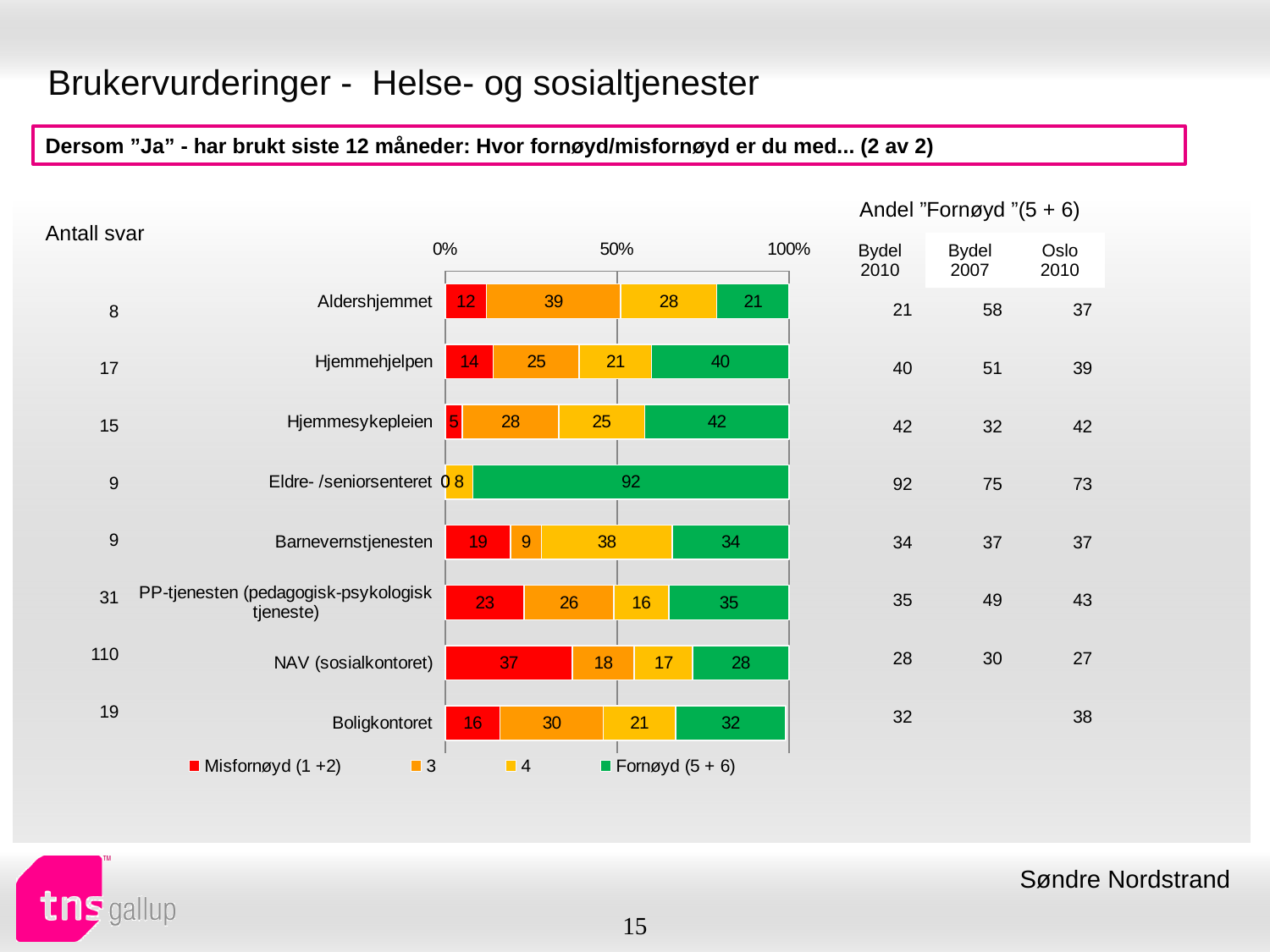
What kind of chart is shown on the slide? stacked bar chart What is the total of the four segments in the Aldershjemmet bar? 100 Which has a larger 'Misfornøyd (1 +2)' value, PP-tjenesten (pedagogisk-psykologisk tjeneste) or Barnevernstjenesten? PP-tjenesten (pedagogisk-psykologisk tjeneste) What is the 'Misfornøyd (1 +2)' value for NAV (sosialkontoret)? 37 Which category has the lowest 'Fornøyd (5 + 6)' value? Aldershjemmet How many service categories are plotted in the bar chart? 8 Which category has the highest 'Fornøyd (5 + 6)' value? Eldre- /seniorsenteret What is the 'Fornøyd (5 + 6)' value for Hjemmesykepleien? 42 Which colour represents 'Fornøyd (5 + 6)' in the chart? green What is the difference between the 'Fornøyd (5 + 6)' values for Hjemmehjelpen and Aldershjemmet? 19 What is the value of series '3' for Boligkontoret? 30 How many series does the chart legend list? 4